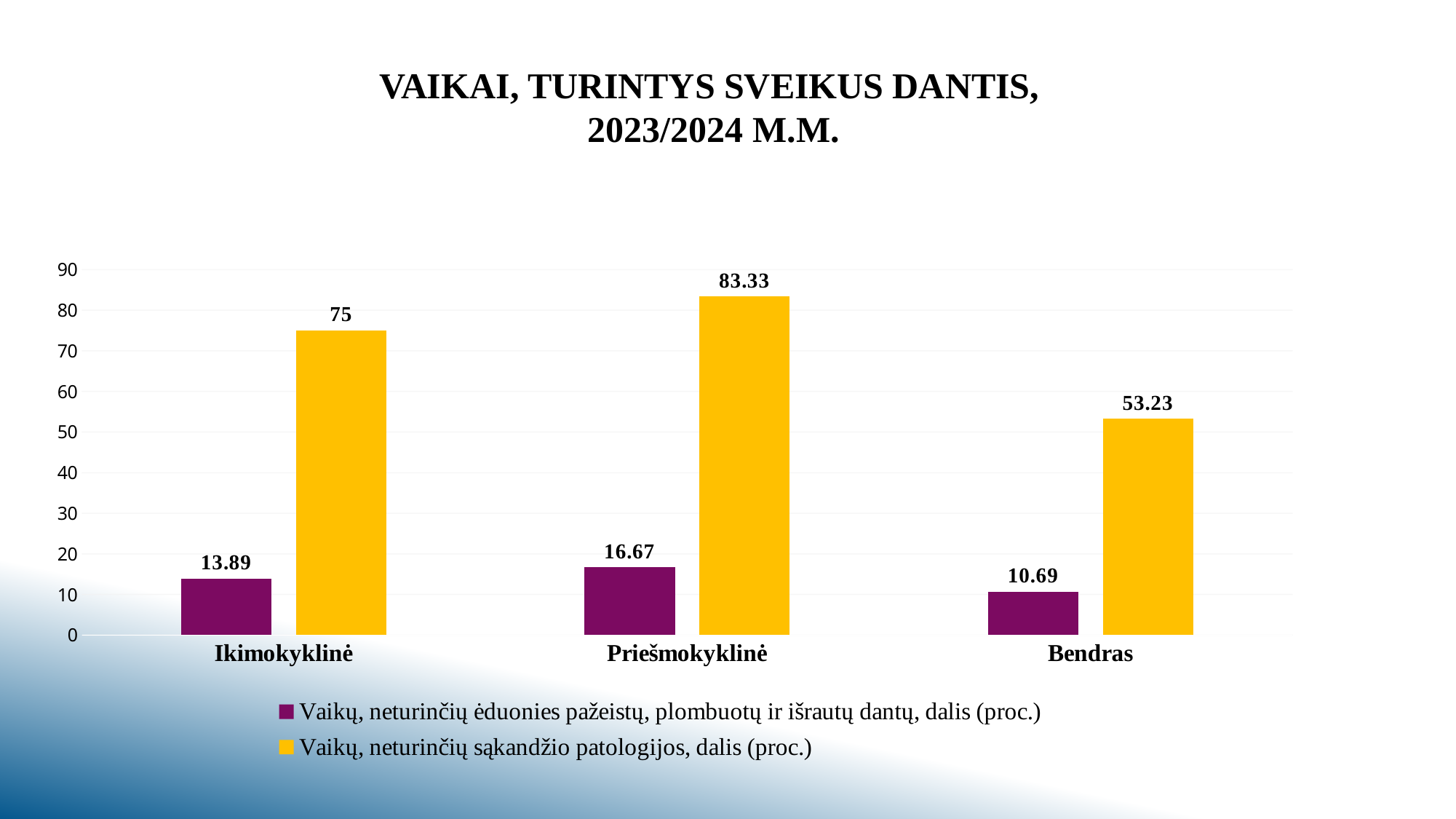
What is the value for Priešmokyklinė in the series 'Vaikų, neturinčių sąkandžio patologijos, dalis (proc.)'? 83.33 What is the difference between the two series values for Priešmokyklinė? 66.66 How many categories are shown on the x axis? 3 Which is larger: the 'Vaikų, neturinčių ėduonies pažeistų, plombuotų ir išrautų dantų, dalis (proc.)' value for Ikimokyklinė or for Bendras? Ikimokyklinė What is the value for Ikimokyklinė in the series 'Vaikų, neturinčių sąkandžio patologijos, dalis (proc.)'? 75 Which category has the lowest value in the series 'Vaikų, neturinčių sąkandžio patologijos, dalis (proc.)'? Bendras What is the title of the chart? VAIKAI, TURINTYS SVEIKUS DANTIS, 2023/2024 M.M. What is the value for Bendras in the series 'Vaikų, neturinčių ėduonies pažeistų, plombuotų ir išrautų dantų, dalis (proc.)'? 10.69 Is the value for Bendras in the series 'Vaikų, neturinčių sąkandžio patologijos, dalis (proc.)' greater or less than 50? greater Which category has the highest value in the series 'Vaikų, neturinčių ėduonies pažeistų, plombuotų ir išrautų dantų, dalis (proc.)'? Priešmokyklinė What kind of chart is shown on the slide? bar chart How many series does the legend list? 2